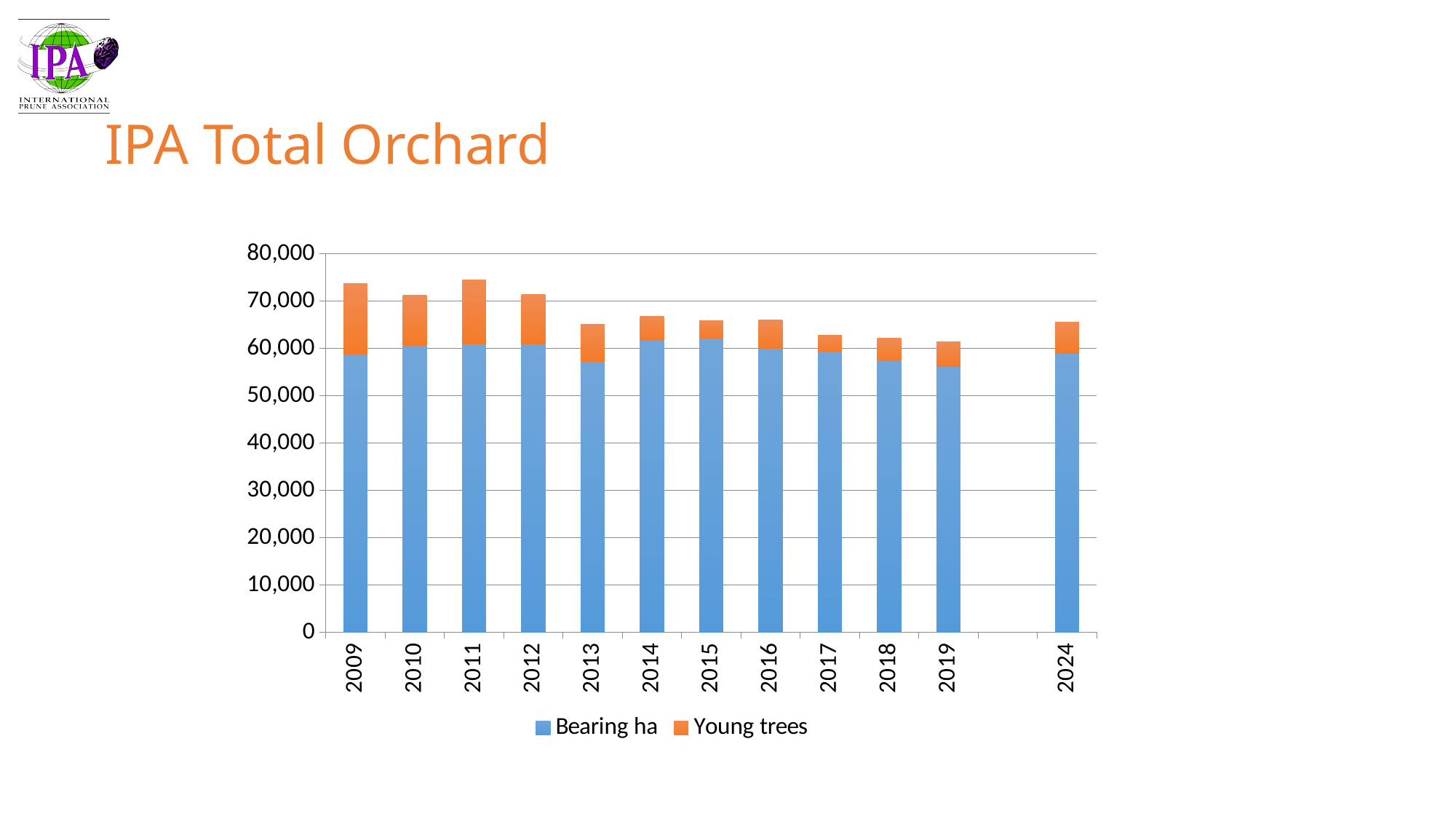
Which year has the larger Young trees value, 2009 or 2014? 2009 Is the total stacked value for 2019 greater or less than 70,000? less What is the title of the slide containing the chart? IPA Total Orchard How many series does the legend list? 2 Is the total stacked value for 2011 greater or less than 70,000? greater Is the Bearing ha value for 2013 greater or less than 60,000? less Do the total stacked values generally rise or fall from 2009 to 2019? fall Which colour represents the Young trees series? orange What kind of chart is shown on the slide? bar chart How many years are shown on the x axis? 12 Which year has the larger total stacked value, 2009 or 2019? 2009